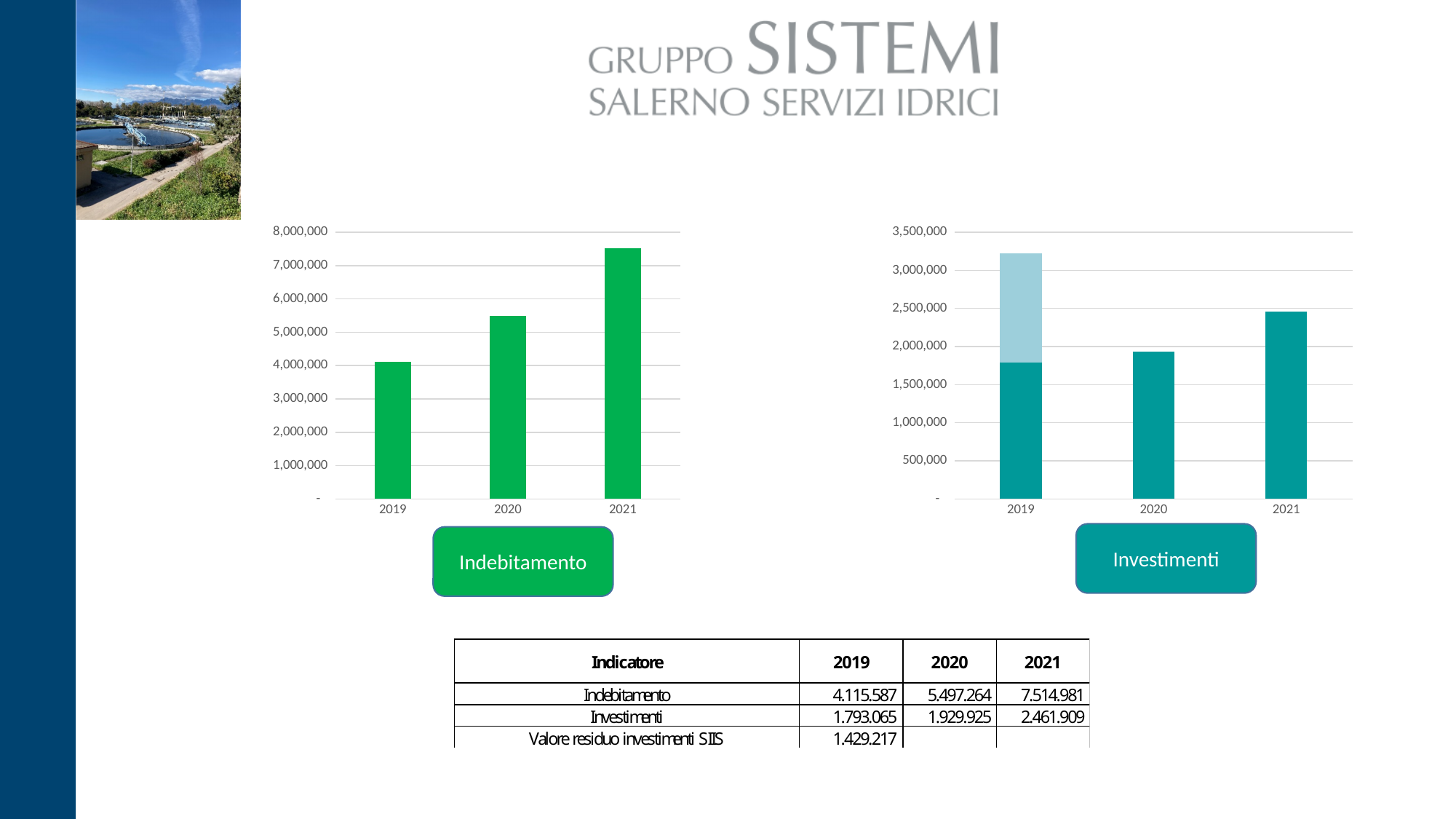
In the Investimenti chart, is the Investimenti value for 2021 greater or less than 2,500,000? less In the Indebitamento chart, which year has the highest value? 2021 What kind of chart is the Indebitamento chart on the left? bar chart In the Indebitamento chart, what is the difference between the 2021 and 2019 values? 3.399.394 In the Investimenti chart, which year has the lowest Investimenti value? 2019 In the Investimenti chart, what is the total height of the stacked 2019 bar (Investimenti plus Valore residuo investimenti SIIS)? 3.222.282 In the Indebitamento chart, do the values rise or fall from 2019 to 2021? rise How many years are shown on the x axis of the Investimenti chart on the right? 3 In the Investimenti chart, which year's bar has a light blue segment stacked on top? 2019 In the Indebitamento chart, what is the value for 2021? 7.514.981 In the Investimenti chart, what is the Investimenti value for 2020? 1.929.925 In the Indebitamento chart, is the value for 2020 greater or less than 5,000,000? greater